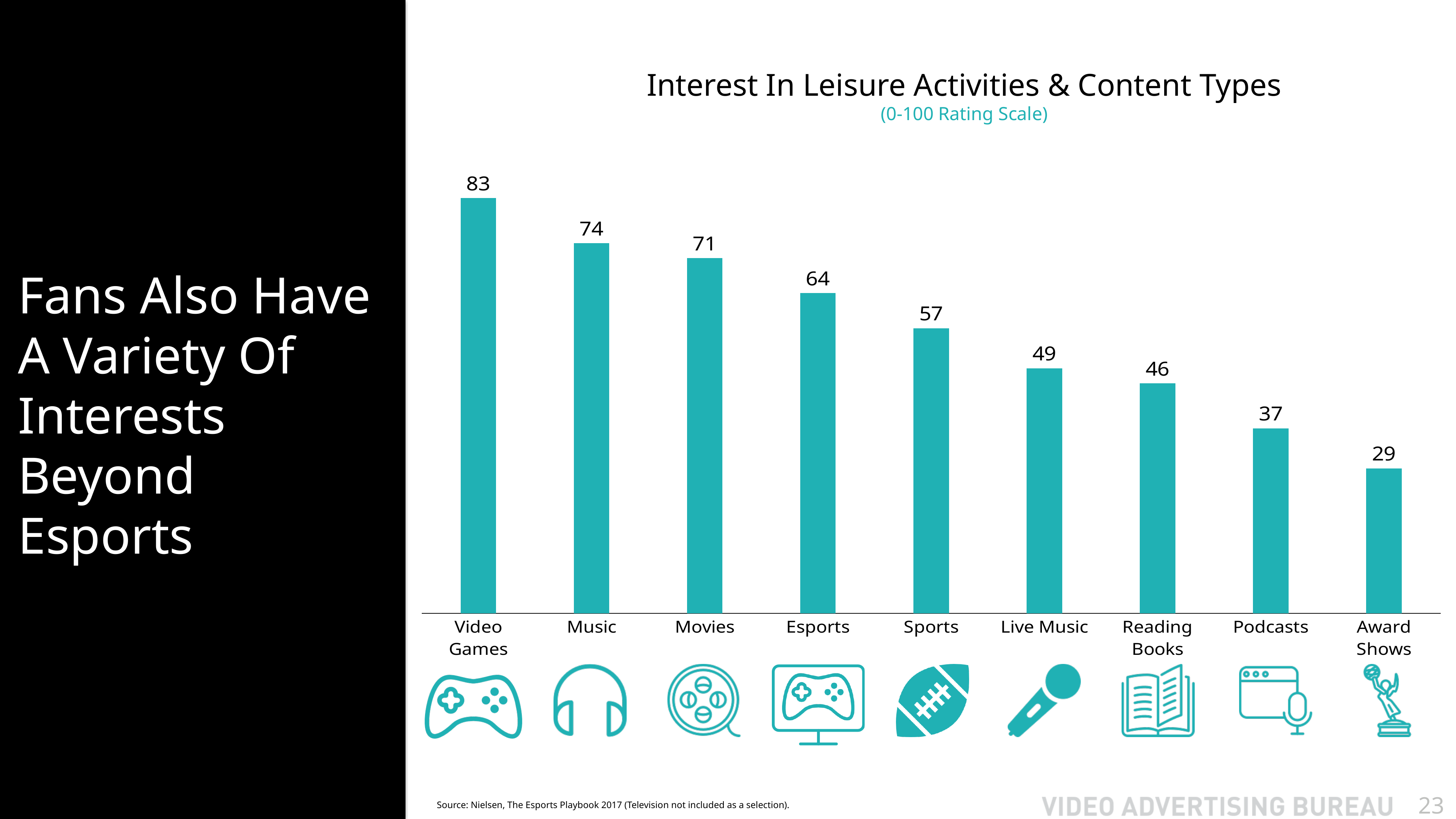
Which has a higher interest rating, Sports or Live Music? Sports Do the values rise or fall from left to right across the categories? Fall What rating scale does the chart subtitle say is used? 0-100 Rating Scale Which category has the highest interest rating? Video Games What is the interest rating for Video Games? 83 What is the interest rating for Podcasts? 37 What kind of chart is shown on the slide? Bar chart What is the interest rating for Esports? 64 What is the difference between the ratings for Music and Movies? 3 How many categories are shown in the chart? 9 What is the difference between the ratings for Video Games and Award Shows? 54 Which category has the lowest interest rating? Award Shows